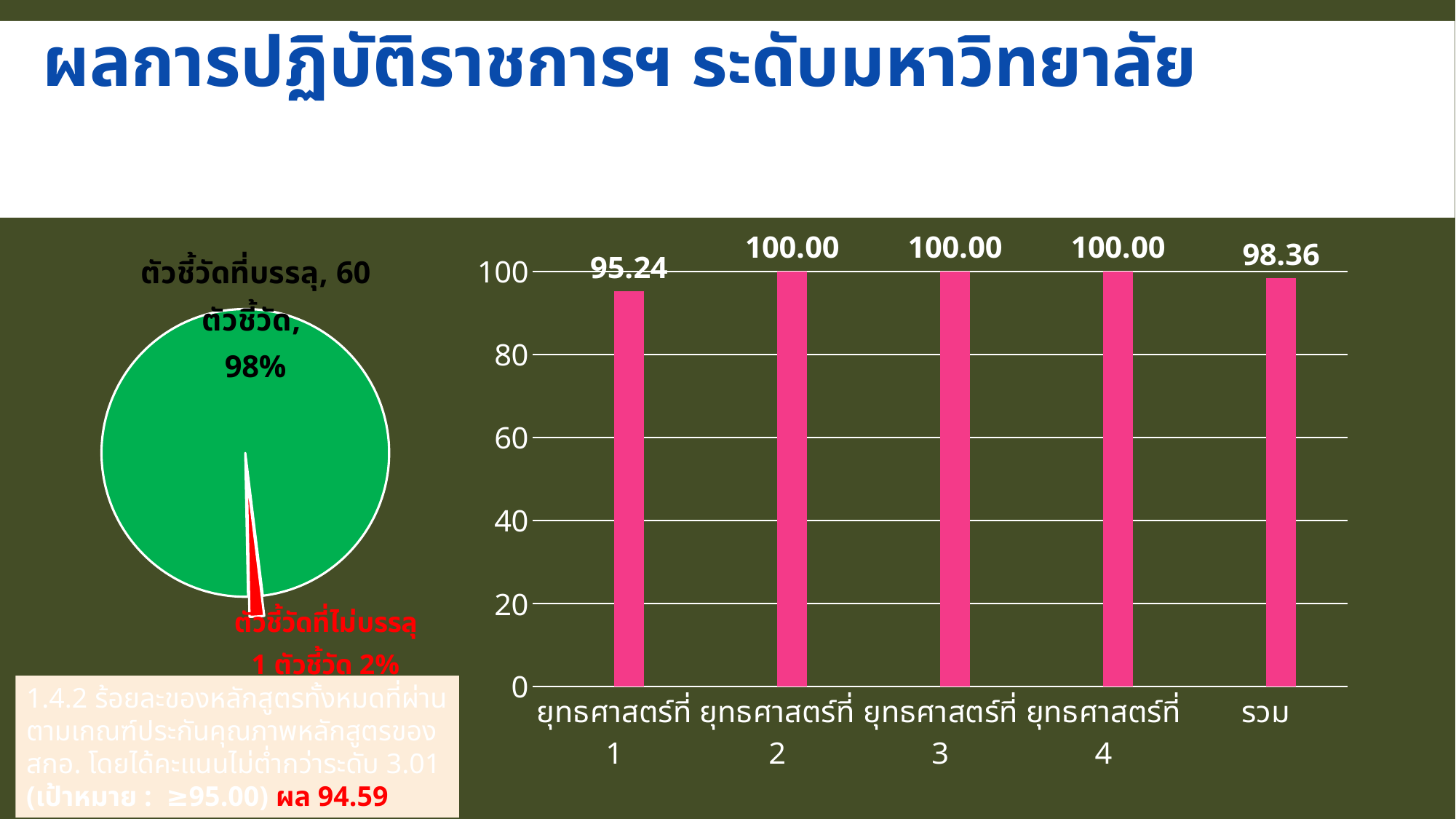
In the pie chart on the left, what share of the pie is ตัวชี้วัดที่บรรลุ? 98% In the bar chart on the right, which is larger: the value for ยุทธศาสตร์ที่ 2 or the value for รวม? ยุทธศาสตร์ที่ 2 In the bar chart on the right, which category has the lowest value? ยุทธศาสตร์ที่ 1 In the bar chart on the right, what is the difference between the value for รวม and the value for ยุทธศาสตร์ที่ 1? 3.12 In the bar chart on the right, what is the value for ยุทธศาสตร์ที่ 1? 95.24 What kind of chart is on the left side of the slide? pie chart In the bar chart on the right, how many categories have a value of 100.00? 3 In the bar chart on the right, what is the value for ยุทธศาสตร์ที่ 3? 100.00 In the bar chart on the right, how many categories are shown on the x axis? 5 In the pie chart on the left, how many indicators are in the ตัวชี้วัดที่ไม่บรรลุ slice? 1 ตัวชี้วัด What kind of chart is on the right side of the slide? bar chart In the bar chart on the right, what is the value for รวม? 98.36